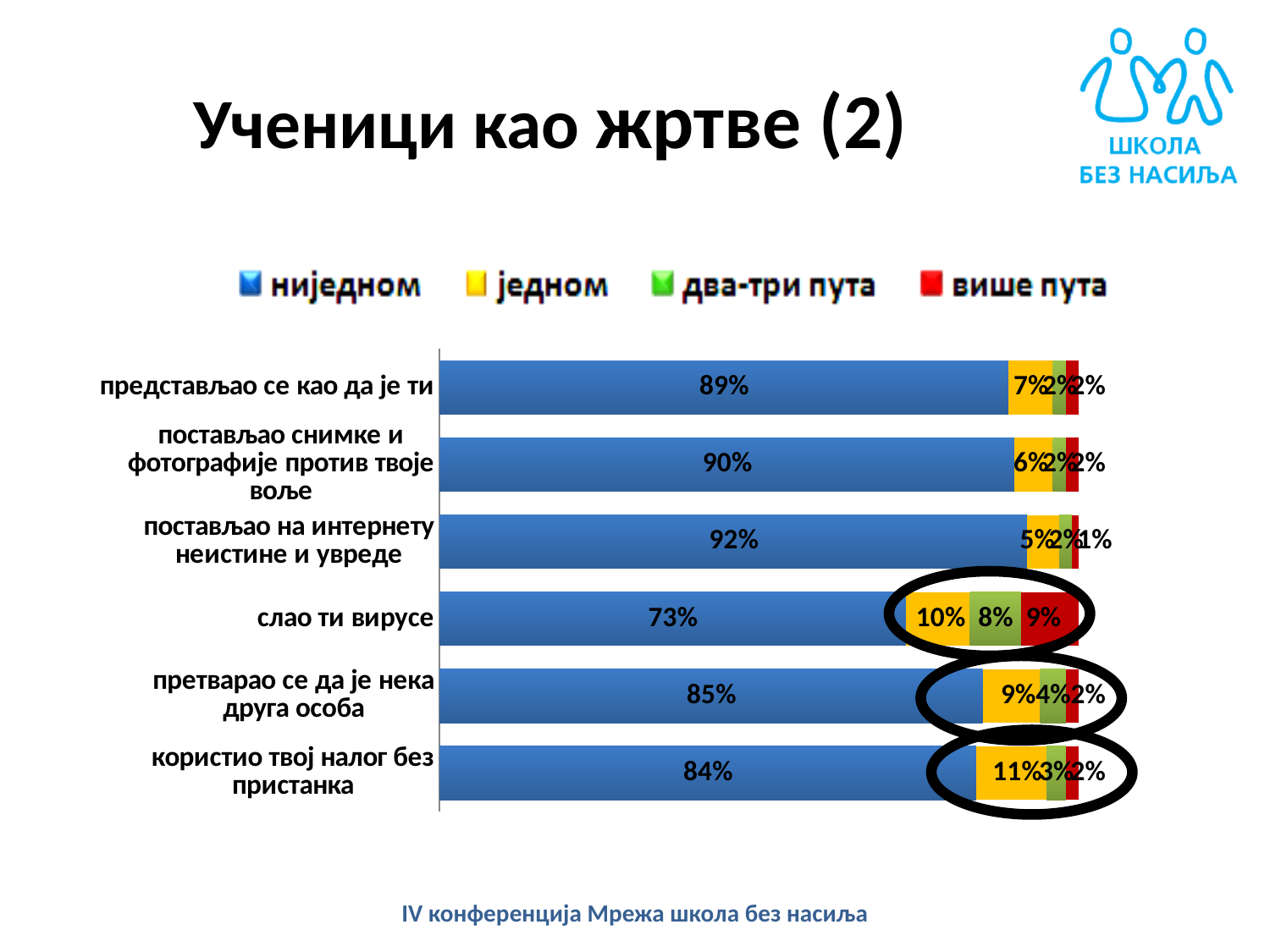
What is the value of "ниједном" for "слао ти вирусе"? 73% What is the value of "два-три пута" for "слао ти вирусе"? 8% Which category has the lowest value for "ниједном"? слао ти вирусе Which legend entry is shown in red? више пута How many series does the legend list? 4 Which category has the highest value for "ниједном"? постављао на интернету неистине и увреде What is the difference between the "ниједном" values for "постављао снимке и фотографије против твоје воље" and "претварао се да је нека друга особа"? 5% What is the value of "једном" for "користио твој налог без пристанка"? 11% How many categories are plotted on the chart? 6 What is the value of "ниједном" for "постављао на интернету неистине и увреде"? 92% What type of chart is shown on the slide? stacked bar chart Which is larger: the "више пута" value for "слао ти вирусе" or for "претварао се да је нека друга особа"? слао ти вирусе